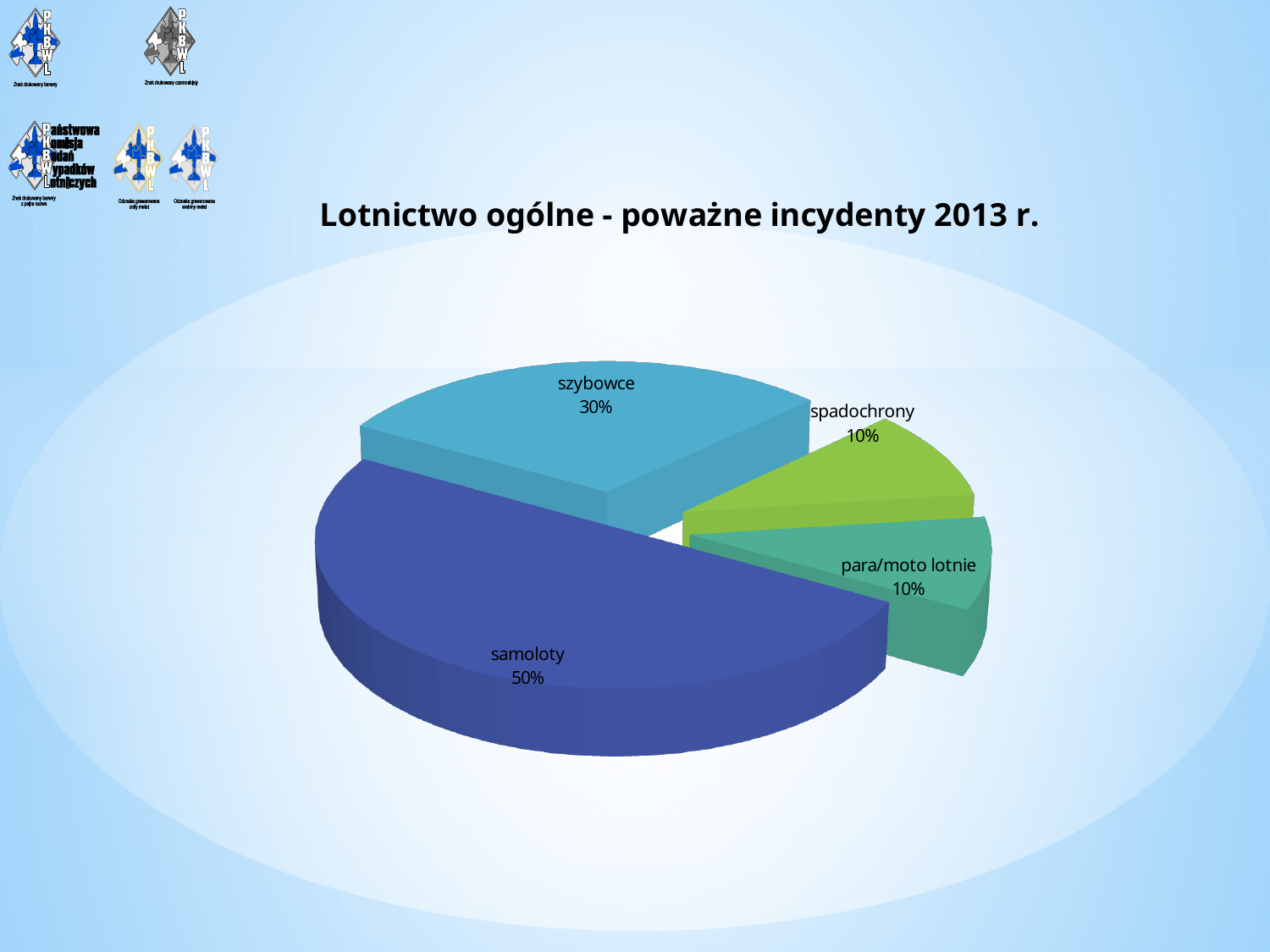
What share of the pie does para/moto lotnie represent? 10% What is the title of the chart? Lotnictwo ogólne - poważne incydenty 2013 r. What is the combined share of spadochrony and para/moto lotnie? 20% How many slices does the pie chart have? 4 What share of the pie does spadochrony represent? 10% What share of the pie does samoloty represent? 50% What is the difference in percentage points between samoloty and szybowce? 20 percentage points Which is larger, the share for szybowce or the share for spadochrony? szybowce What type of chart is shown on the slide? pie chart What colour is the samoloty slice? blue Which category has the largest slice of the pie? samoloty